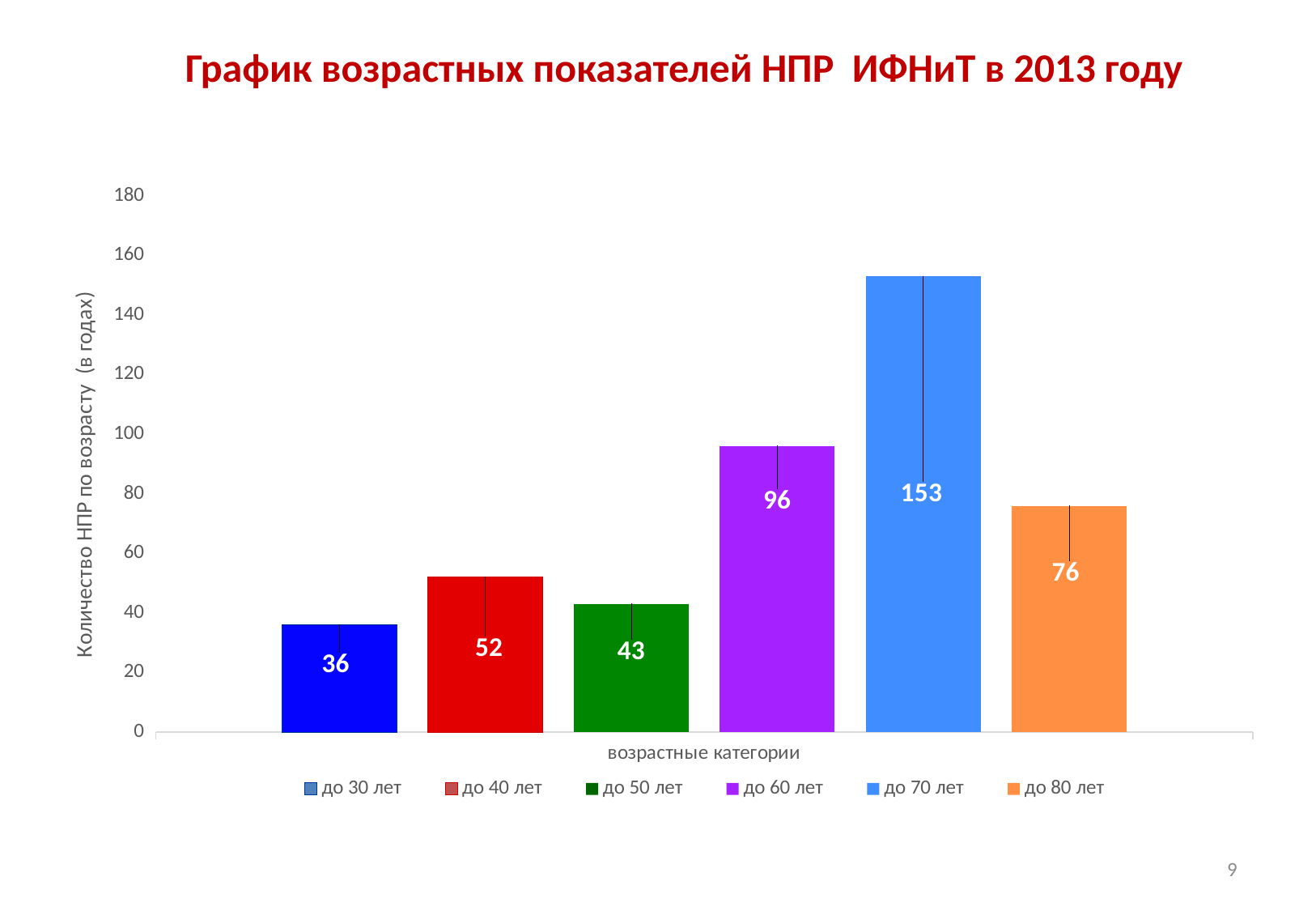
What is the difference between the values for 'до 40 лет' and 'до 50 лет'? 9 What is the title of the chart? График возрастных показателей НПР ИФНиТ в 2013 году What is the value for the 'до 70 лет' category? 153 Is the value for 'до 70 лет' greater or less than 140? greater Which age category has the highest value? до 70 лет How many age categories are shown in the chart? 6 What kind of chart is shown on the slide? bar chart Which age category has the lowest value? до 30 лет What is the difference between the values for 'до 70 лет' and 'до 60 лет'? 57 Which is larger, the value for 'до 80 лет' or the value for 'до 40 лет'? до 80 лет What is the value for the 'до 30 лет' category? 36 What is the value for the 'до 60 лет' category? 96